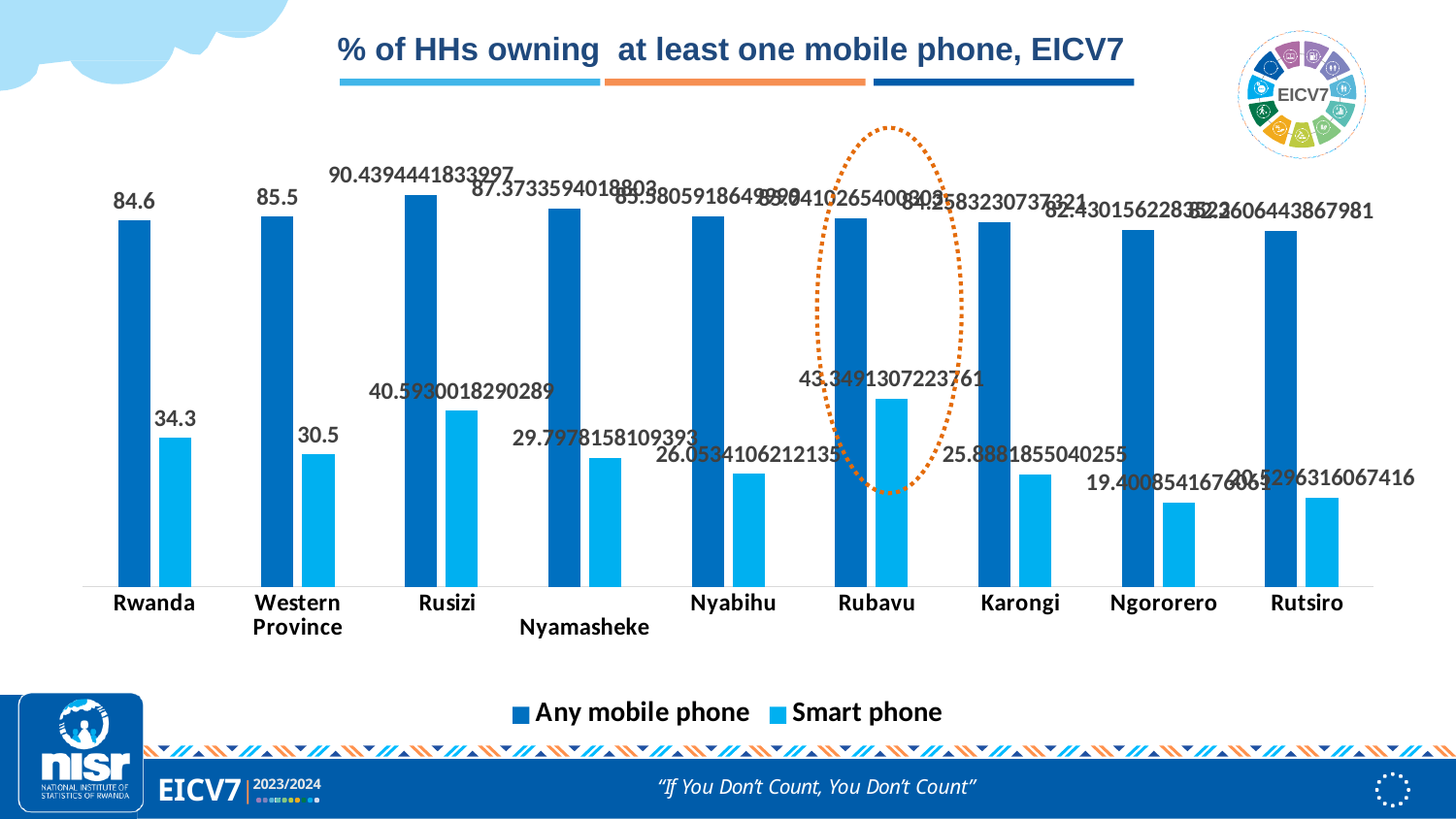
Which category is highlighted with a dotted orange circle? Rubavu What is the value for Any mobile phone in Rwanda? 84.6 What is the value for Smart phone in Rubavu? 43.3491307223761 What is the value for Smart phone in Karongi? 25.8881855040255 What is the value for Smart phone in Western Province? 30.5 Which is larger, the Smart phone value for Rwanda or for Western Province? Rwanda Which category has the highest value for Any mobile phone? Rusizi What is the difference between the Any mobile phone and Smart phone values for Rwanda? 50.3 How many series does the legend list? 2 Which category has the highest value for Smart phone? Rubavu How many categories are shown on the x axis? 9 What kind of chart is shown on the slide? Bar chart